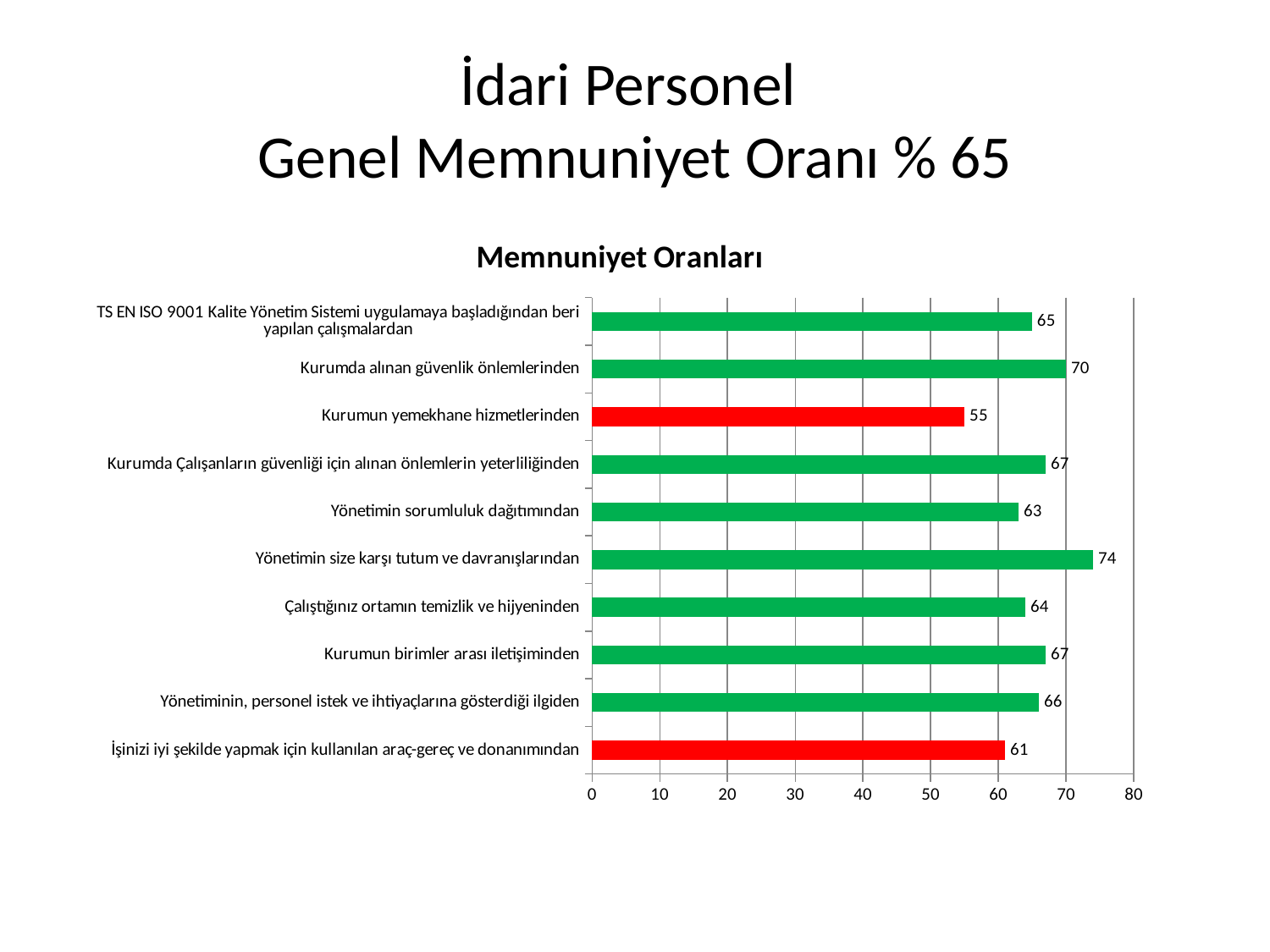
How many bars are coloured red? 2 Which is larger: the value for "Yönetimin sorumluluk dağıtımından" or the value for "Çalıştığınız ortamın temizlik ve hijyeninden"? Çalıştığınız ortamın temizlik ve hijyeninden What is the value for "Yönetimin size karşı tutum ve davranışlarından"? 74 What is the value for "Kurumun yemekhane hizmetlerinden"? 55 What is the value for "Kurumda alınan güvenlik önlemlerinden"? 70 Which category has the highest value? Yönetimin size karşı tutum ve davranışlarından What is the title of the chart? Memnuniyet Oranları Which category has the lowest value? Kurumun yemekhane hizmetlerinden Is the value for "İşinizi iyi şekilde yapmak için kullanılan araç-gereç ve donanımından" greater or less than 70? less What kind of chart is shown on the slide? bar chart What is the difference between the values for "Kurumda alınan güvenlik önlemlerinden" and "Kurumun yemekhane hizmetlerinden"? 15 How many categories are shown in the chart? 10